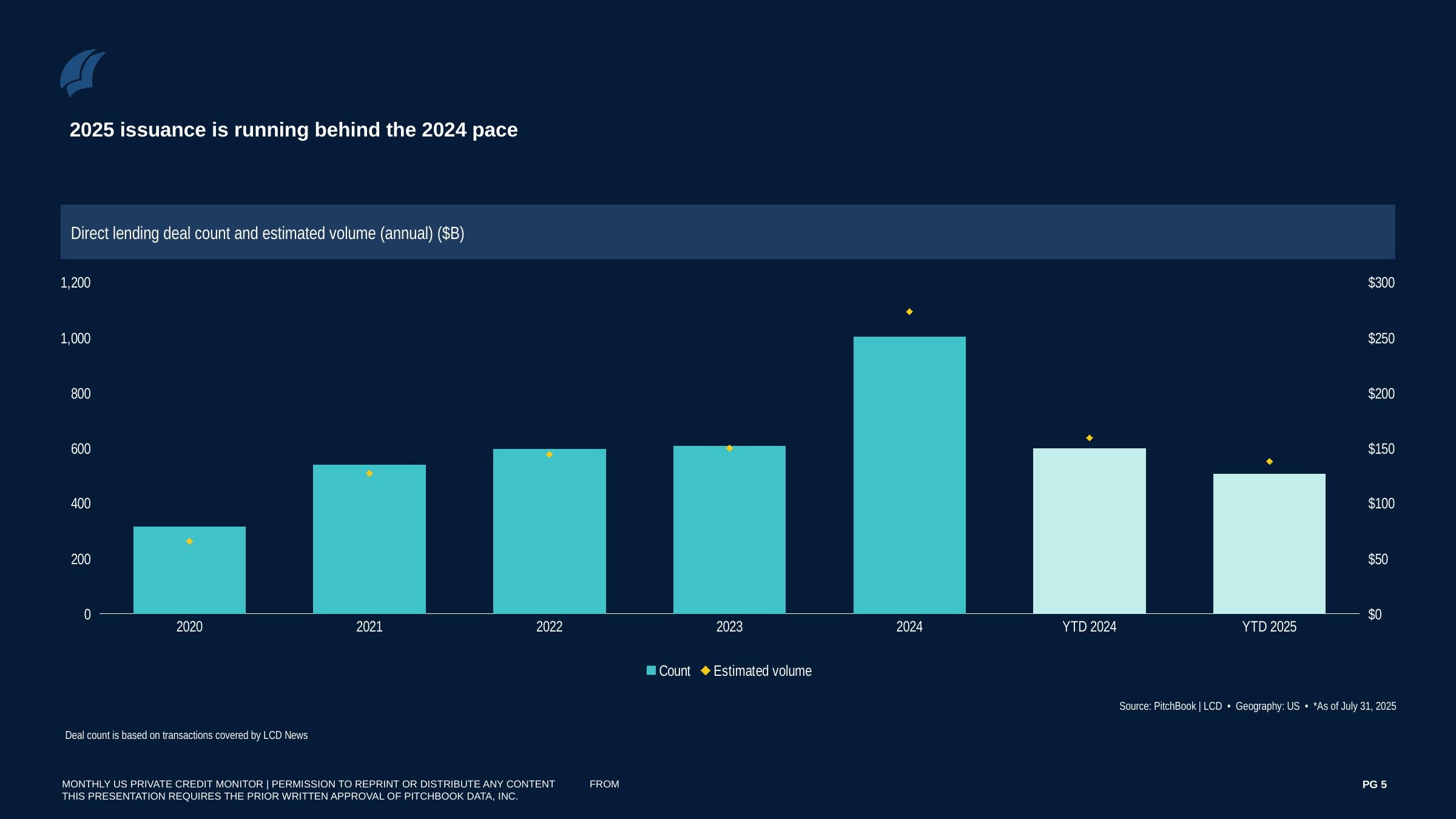
How many categories are shown on the x axis? 7 Is the deal count for 2024 greater or less than 800? greater Is the deal count for 2020 greater or less than 400? less Which category has the lowest deal count? 2020 Which category has the highest deal count? 2024 Is the estimated volume for 2024 greater or less than $250? greater What is the title of the chart? Direct lending deal count and estimated volume (annual) ($B) Does the deal count rise or fall from 2020 to 2024? rise Which has the larger deal count, YTD 2024 or YTD 2025? YTD 2024 What kind of chart is used to show the Count series? bar chart Which has the larger estimated volume, YTD 2024 or YTD 2025? YTD 2024 How many series does the legend list? 2